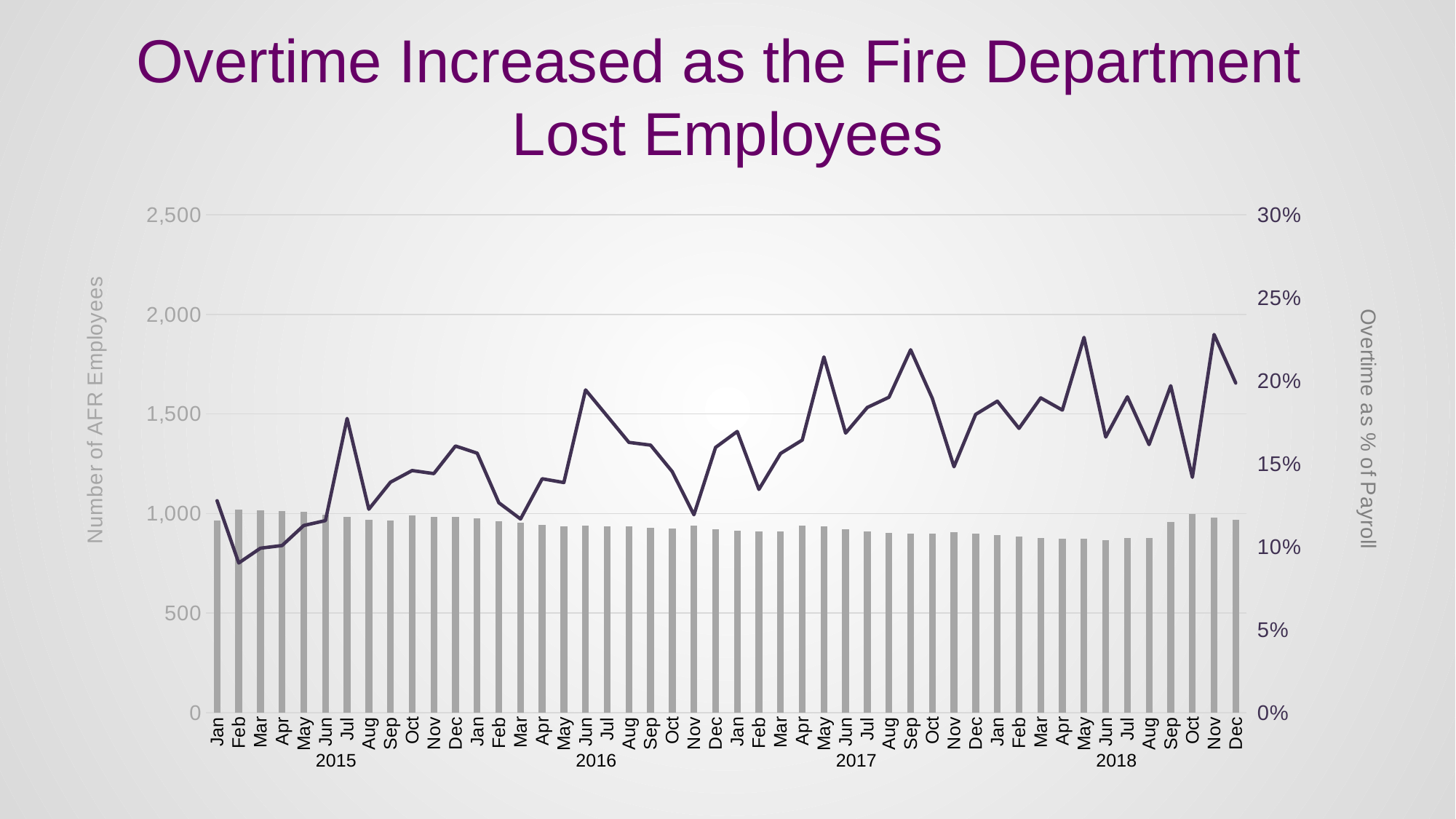
Which month has the higher overtime as % of payroll, Feb 2015 or Nov 2018? Nov 2018 In which month is overtime as % of payroll at its lowest? Feb 2015 Is the number of AFR employees in Jun 2018 greater or less than 1,000? less Does overtime as % of payroll generally rise or fall from 2015 to 2018? rise How many monthly data points are plotted for each series? 48 What does the right-hand vertical axis measure? Overtime as % of Payroll Is the number of AFR employees in Jan 2015 greater or less than 500? greater What kind of chart is shown on the slide? A combined bar and line chart What is the title of the chart on the slide? Overtime Increased as the Fire Department Lost Employees Is the overtime as % of payroll for Nov 2018 greater or less than 20%? greater How many years of monthly data are shown on the x axis? 4